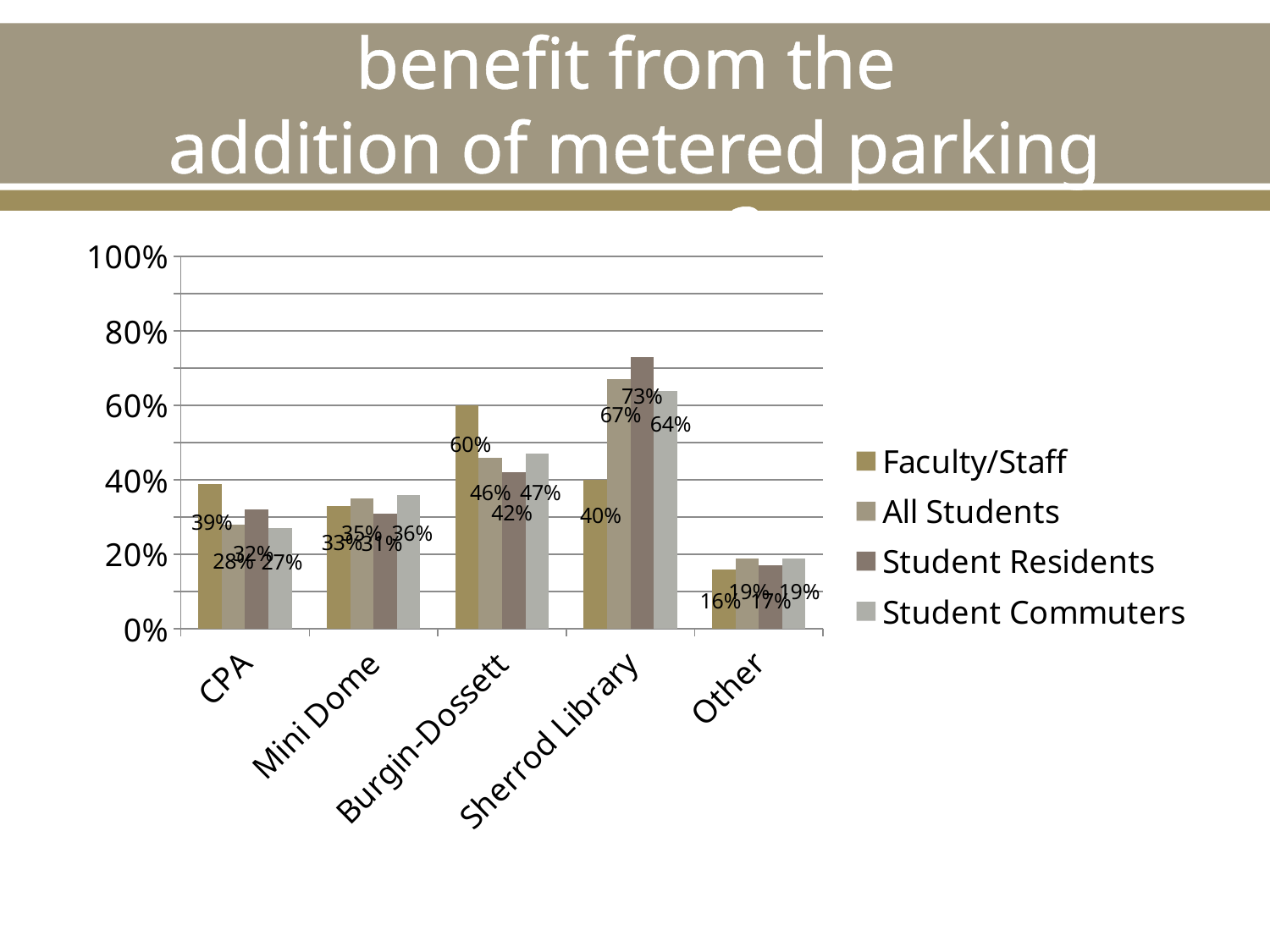
How many series does the legend list? 4 What is the Faculty/Staff value for CPA? 39% For Sherrod Library, which is larger: the Faculty/Staff value or the All Students value? All Students What is the Student Commuters value for Sherrod Library? 64% What is the difference between the Faculty/Staff and All Students values for Burgin-Dossett? 14% What kind of chart is shown on the slide? bar chart How many categories are shown on the x axis? 5 Which category has the lowest Faculty/Staff value? Other Which category has the highest Student Residents value? Sherrod Library What is the Student Residents value for Sherrod Library? 73% Which series is shown in the lightest grey colour in the legend? Student Commuters What is the Faculty/Staff value for Burgin-Dossett? 60%